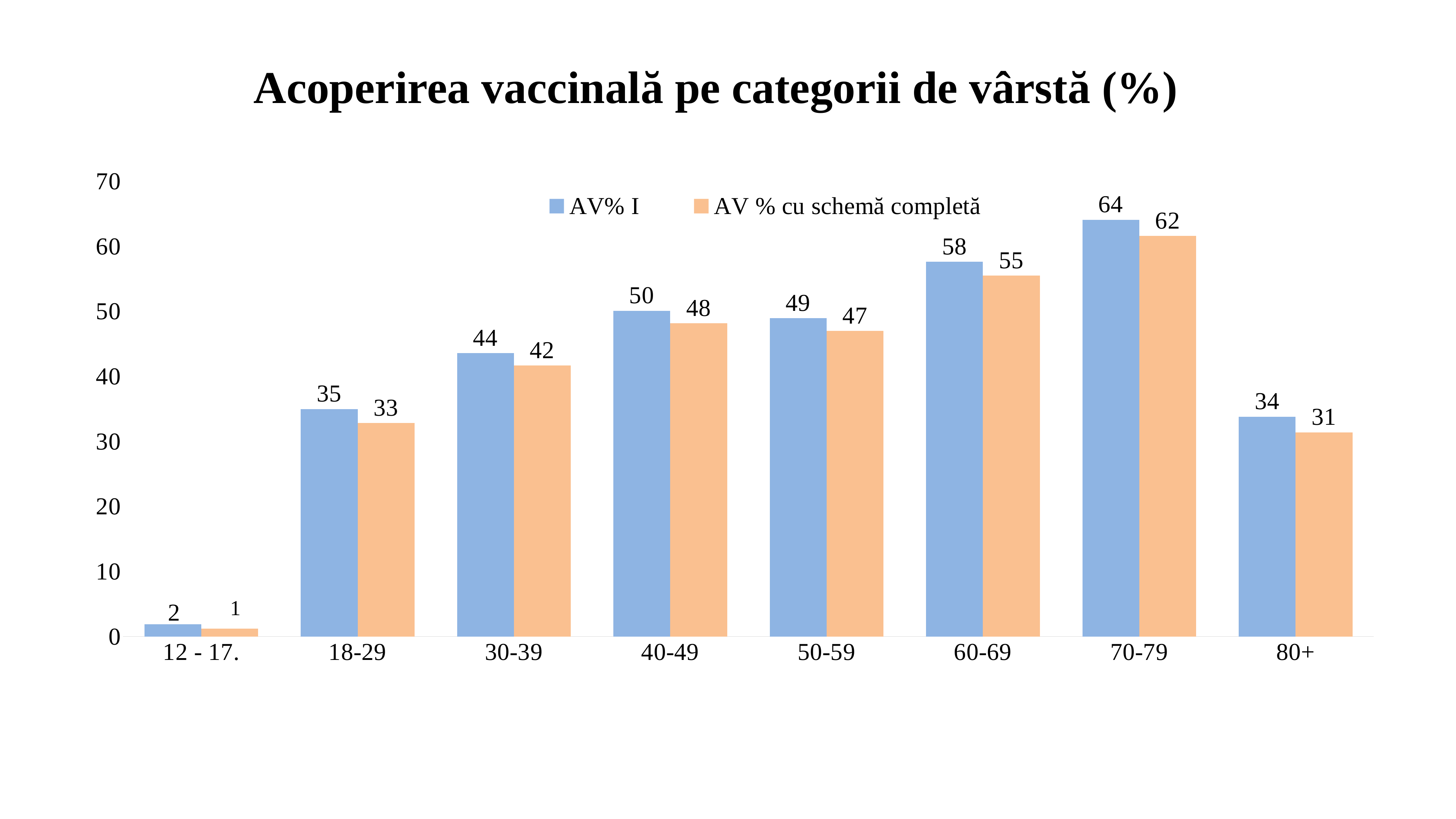
Which colour represents the AV % cu schemă completă series? Orange What is the AV% I value for the 40-49 age group? 50 What kind of chart is shown on the slide? Bar chart Which is larger: the AV% I value for 50-59 or the AV% I value for 60-69? 60-69 How many age groups are shown on the x axis? 8 Which age group has the lowest AV % cu schemă completă value? 12 - 17. What is the AV % cu schemă completă value for the 60-69 age group? 55 Do the AV% I values rise or fall from the 18-29 group to the 70-79 group? Rise What is the difference between the AV% I and AV % cu schemă completă values for the 80+ age group? 3 Which age group has the highest AV% I value? 70-79 What is the title of the chart? Acoperirea vaccinală pe categorii de vârstă (%) How many series does the legend list? 2